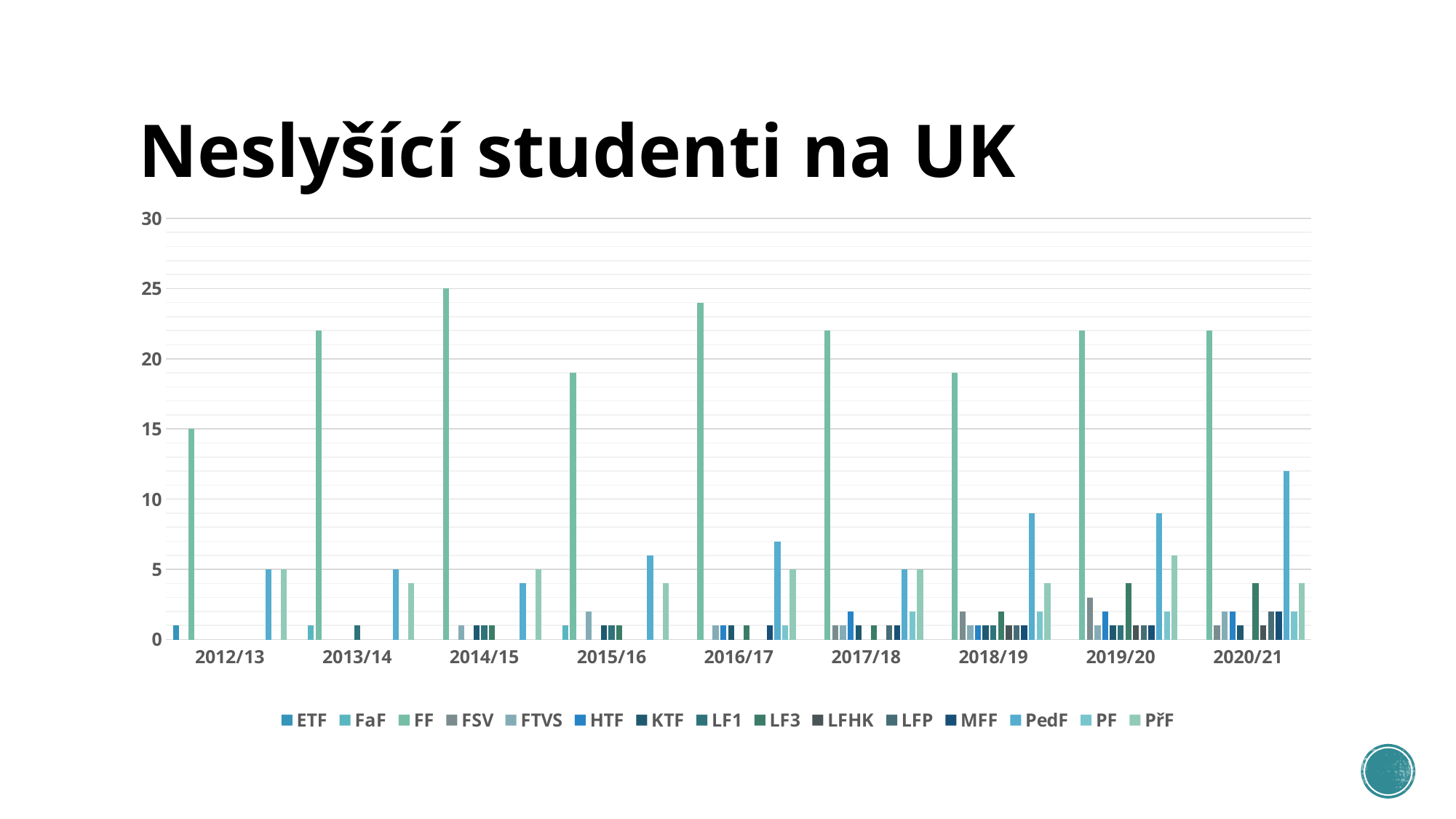
Is the value for FF in 2017/18 greater or less than 20? greater How many series does the legend list? 15 Is the value for PedF in 2020/21 greater or less than 10? greater Which is larger, the FF value in 2012/13 or the FF value in 2013/14? 2013/14 What is the value for FF in 2012/13? 15 What is the title of the chart? Neslyšící studenti na UK What kind of chart is shown on the slide? bar chart How many academic years are shown on the x axis? 9 Is the value for FF in 2015/16 greater or less than 20? less What is the difference between the FF value in 2014/15 and the FF value in 2012/13? 10 In which academic year is the FF value lowest? 2012/13 What is the value for FF in 2014/15? 25